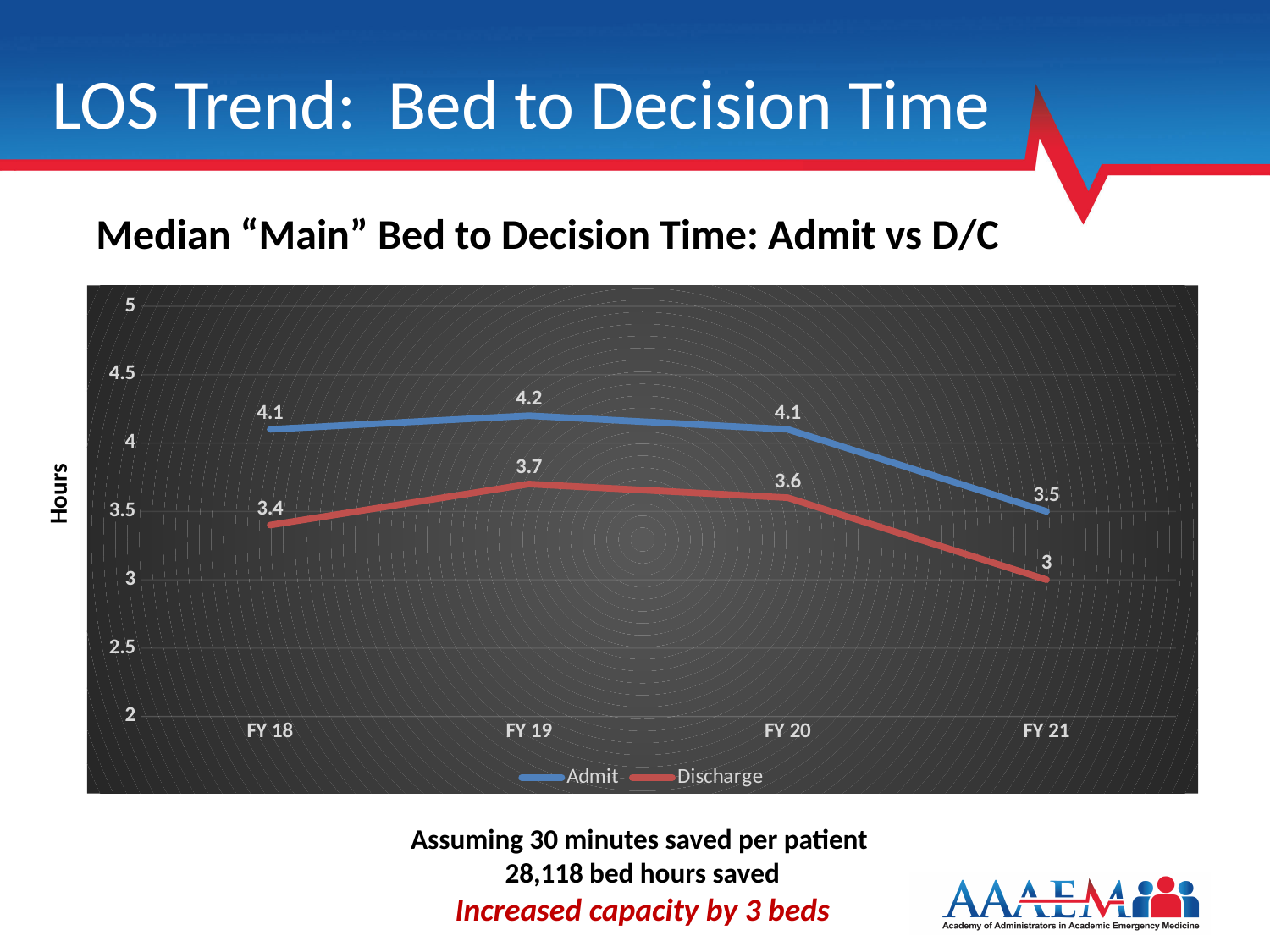
What is the Discharge value for FY 18? 3.4 Which is larger in FY 21, the Admit value or the Discharge value? Admit What kind of chart is shown? Line chart What is the Discharge value for FY 21? 3 In which fiscal year is the Admit series highest? FY 19 What is the Admit value for FY 19? 4.2 What is the label on the vertical axis? Hours How many series does the legend list? 2 In which fiscal year is the Discharge series lowest? FY 21 What is the difference between the Admit and Discharge values in FY 20? 0.5 How many fiscal years are shown on the x axis? 4 Does the Admit series rise or fall from FY 20 to FY 21? Fall